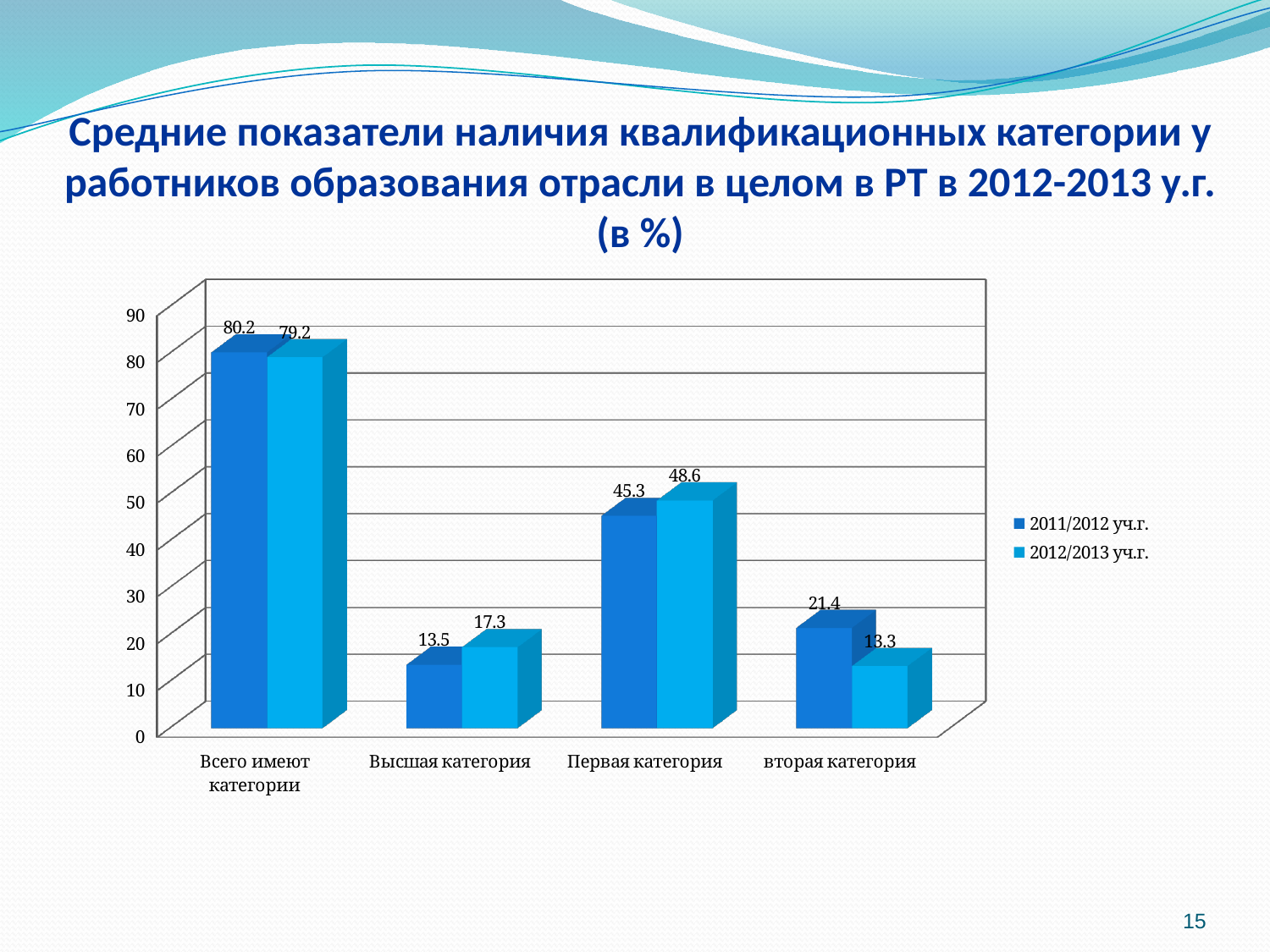
What are the two series names listed in the legend? 2011/2012 уч.г. and 2012/2013 уч.г. Which category has the highest value in the 2012/2013 уч.г. series? Всего имеют категории What is the difference between the 2011/2012 уч.г. and 2012/2013 уч.г. values for 'вторая категория'? 8.1 How many series does the legend list? 2 How many categories are shown on the x axis? 4 Which category has the lowest value in the 2011/2012 уч.г. series? Высшая категория What kind of chart is shown on the slide? Bar chart Which is larger for 'Первая категория': the 2011/2012 уч.г. value or the 2012/2013 уч.г. value? 2012/2013 уч.г. What is the value for 'Первая категория' in the 2012/2013 уч.г. series? 48.6 What is the value for 'вторая категория' in the 2011/2012 уч.г. series? 21.4 What is the value for 'Высшая категория' in the 2012/2013 уч.г. series? 17.3 What is the value for 'Всего имеют категории' in the 2011/2012 уч.г. series? 80.2